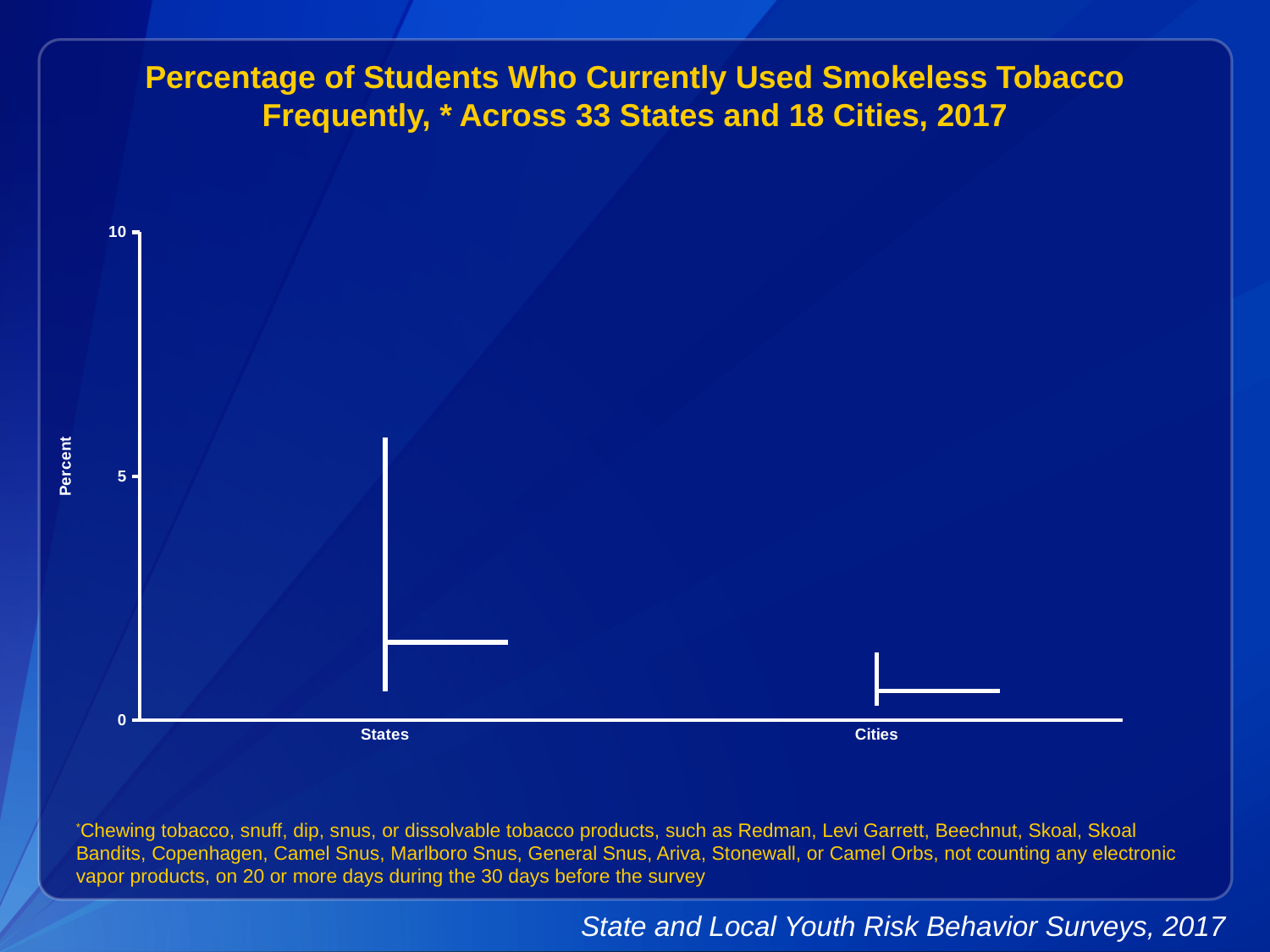
Is the median value for Cities greater or less than 5? less What are the two categories shown on the x axis? States and Cities Which category shows the wider range of values? States Is the top of the range for States greater or less than 5? greater Which category has the higher median value, States or Cities? States What is the label of the y axis? Percent How many categories are shown on the x axis of the chart? 2 What is the highest value shown on the y axis? 10 Which category has the lowest median value? Cities Is the top of the range for Cities greater or less than 5? less